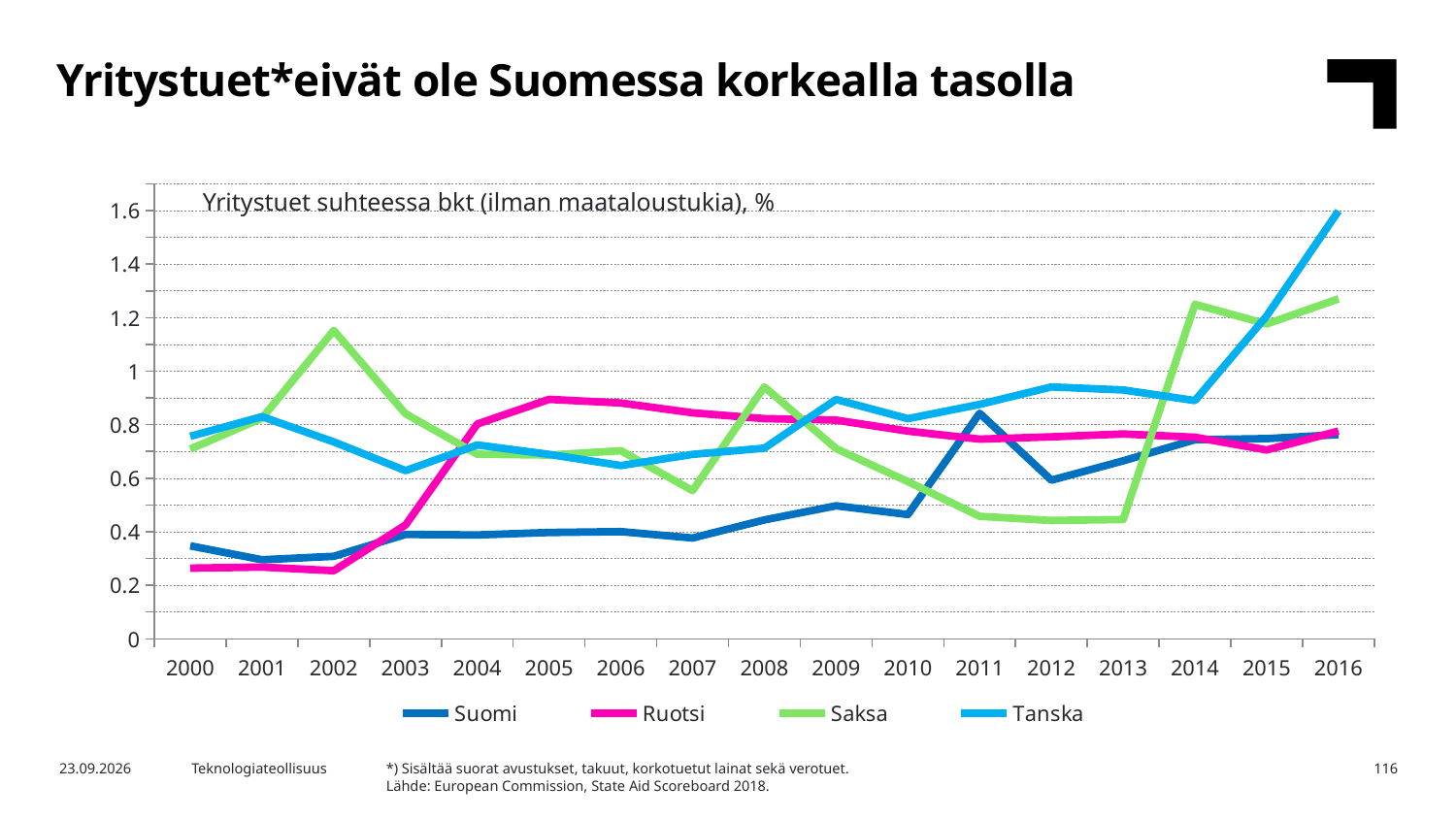
Which country has the highest value in 2002? Saksa Which is larger in 2002, the value for Saksa or the value for Suomi? Saksa Is the value for Tanska in 2016 greater or less than 1.4? greater How many series does the legend list? 4 Does the value for Tanska rise or fall from 2013 to 2016? rise How many years are shown on the x axis? 17 Is the value for Suomi in 2010 greater or less than 0.6? less What is the title of the chart? Yritystuet suhteessa bkt (ilman maataloustukia), % Is the value for Saksa in 2014 greater or less than 1? greater Which country has the highest value in 2016? Tanska What kind of chart is shown on the slide? line chart